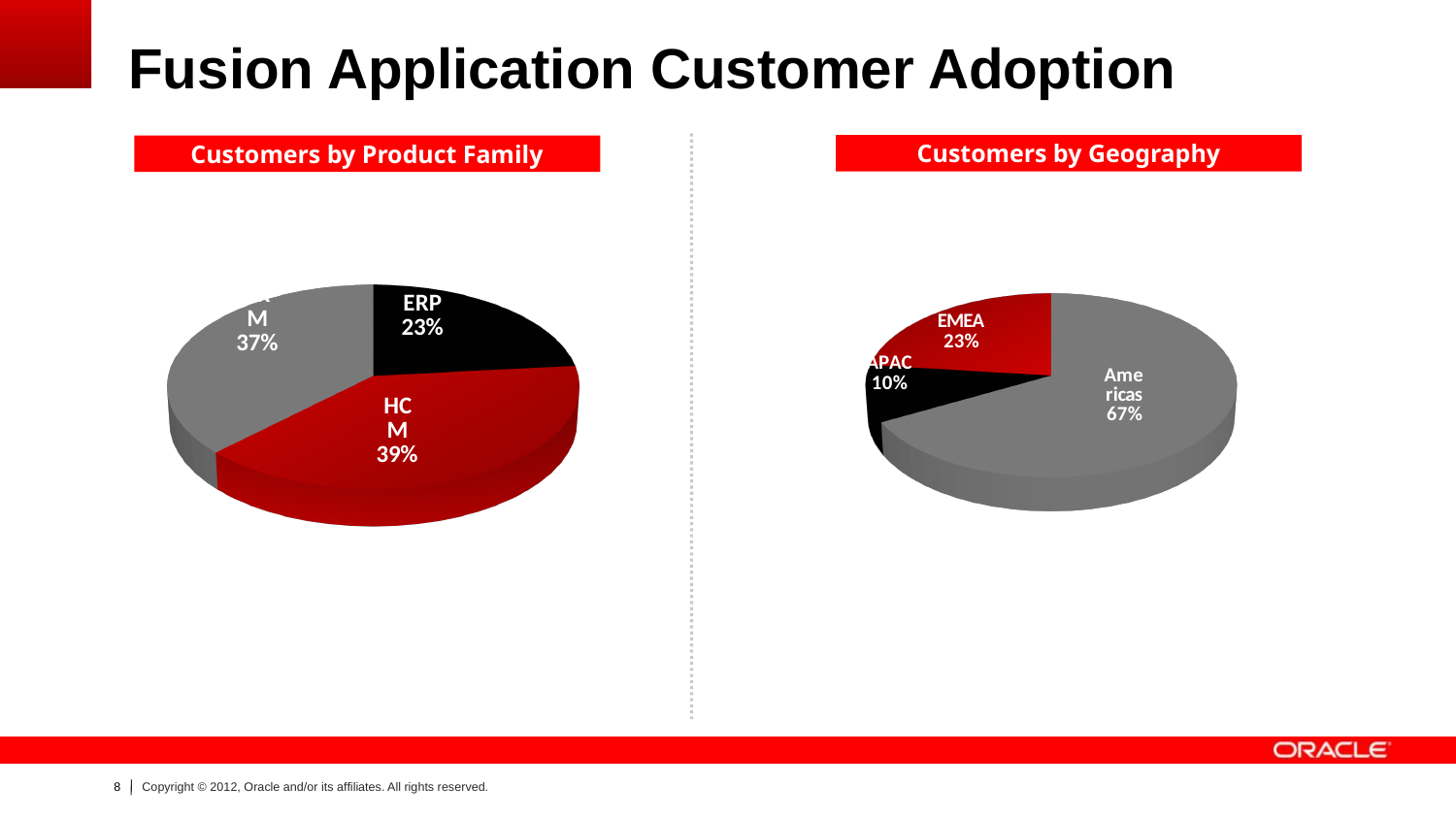
In the Customers by Geography chart, what share of customers is in APAC? 10% In the Customers by Product Family chart, what share of customers is HCM? 39% In the Customers by Geography chart, which region has the smallest share? APAC In the Customers by Product Family chart, which product family has the smallest share? ERP What type of chart is the Customers by Geography chart? Pie chart In the Customers by Geography chart, what share of customers is in EMEA? 23% In the Customers by Geography chart, what share of customers is in the Americas? 67% In the Customers by Product Family chart, which product family has the largest share? HCM In the Customers by Geography chart, what is the difference between the EMEA and APAC shares? 13% In the Customers by Product Family chart, what is the difference between the HCM and ERP shares? 16% In the Customers by Geography chart, which region has the largest share? Americas In the Customers by Product Family chart, what share of customers is ERP? 23%